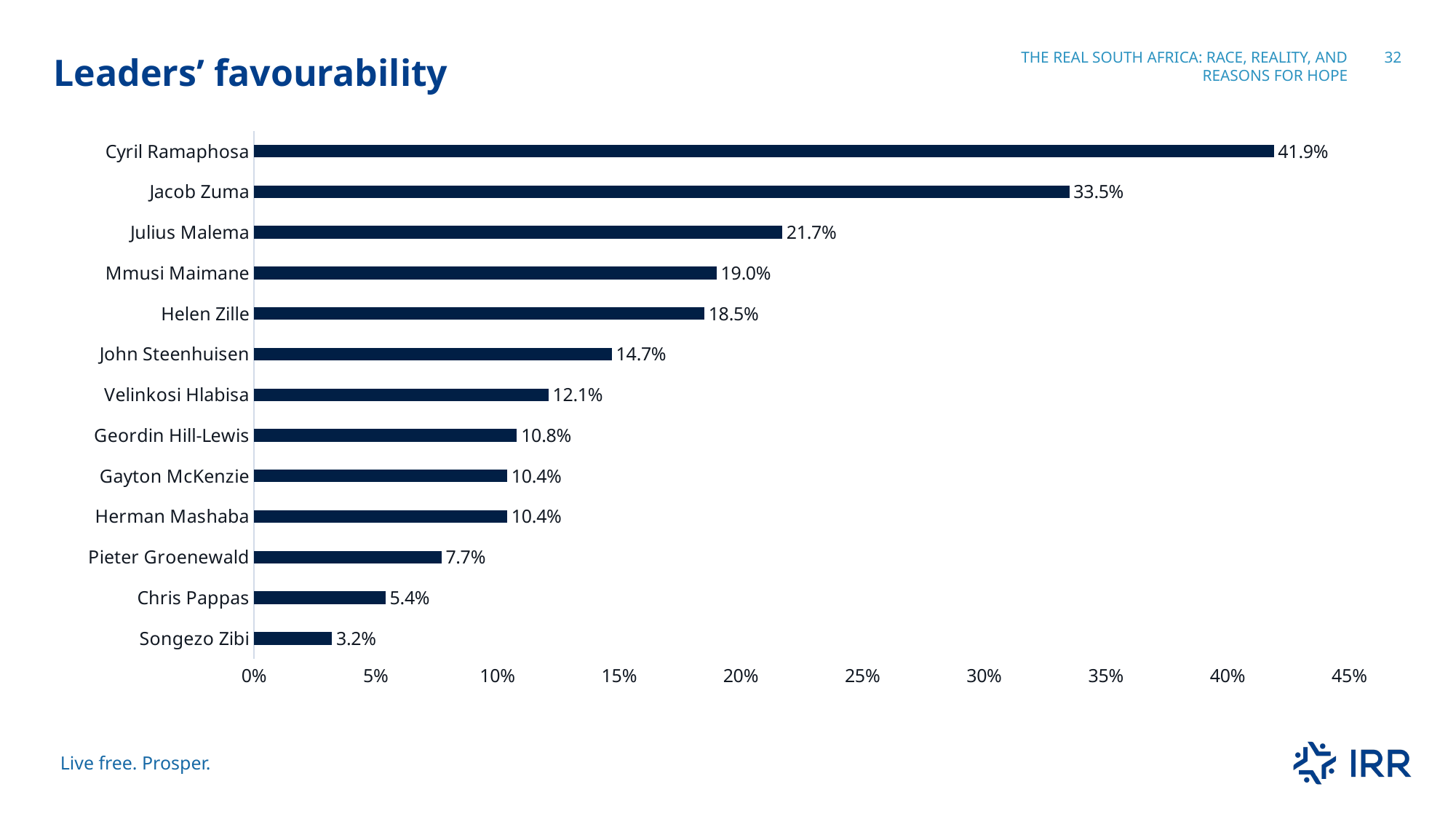
How many leaders are shown in the chart? 13 Who has the higher favourability, Mmusi Maimane or Velinkosi Hlabisa? Mmusi Maimane What is the favourability value for Cyril Ramaphosa? 41.9% What is the difference between Julius Malema's and John Steenhuisen's favourability? 7.0% What is the difference between Cyril Ramaphosa's and Jacob Zuma's favourability? 8.4% What is the favourability value for Helen Zille? 18.5% What is the title of the slide? Leaders' favourability What kind of chart is shown on the slide? Bar chart Which leader has the highest favourability? Cyril Ramaphosa What is the favourability value for Pieter Groenewald? 7.7% Is the value for Chris Pappas greater or less than 10%? less Which leader has the lowest favourability? Songezo Zibi